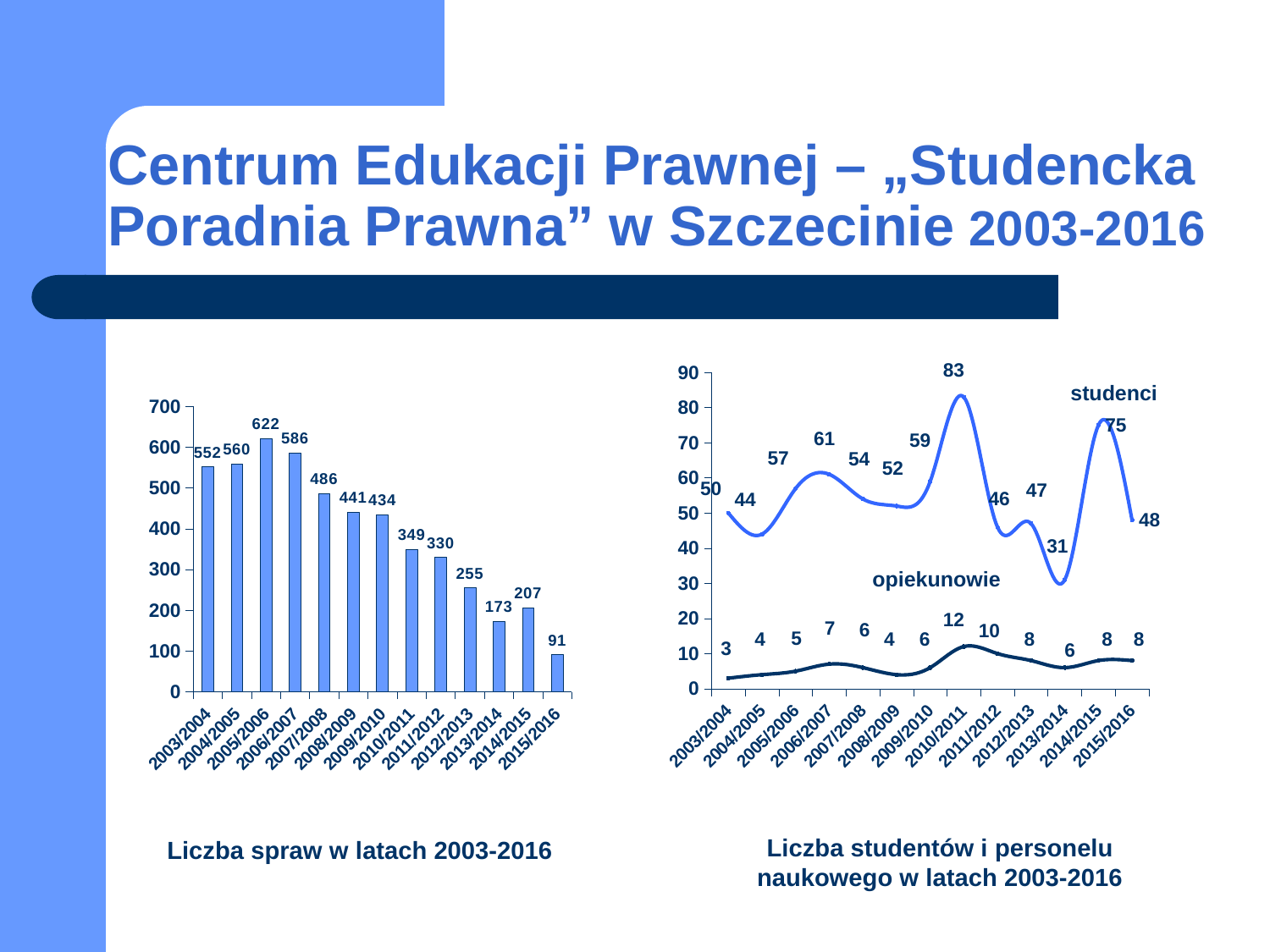
In the left chart (Liczba spraw w latach 2003-2016), do the values generally rise or fall from 2006/2007 to 2013/2014? Fall In the left chart (Liczba spraw w latach 2003-2016), which academic year has the lowest value? 2015/2016 In the left chart (Liczba spraw w latach 2003-2016), what is the value for 2005/2006? 622 In the left chart (Liczba spraw w latach 2003-2016), what is the difference between the values for 2003/2004 and 2015/2016? 461 In the left chart (Liczba spraw w latach 2003-2016), which academic year has the highest value? 2005/2006 In the right chart (Liczba studentów i personelu naukowego), which year has the lowest value for studenci? 2013/2014 What kind of chart is the left chart (Liczba spraw w latach 2003-2016)? Bar chart In the right chart (Liczba studentów i personelu naukowego), what is the value for opiekunowie in 2011/2012? 10 In the left chart (Liczba spraw w latach 2003-2016), how many academic years are shown on the x axis? 13 In the right chart (Liczba studentów i personelu naukowego), how many series are plotted? 2 In the right chart (Liczba studentów i personelu naukowego), what is the value for studenci in 2010/2011? 83 In the right chart (Liczba studentów i personelu naukowego), which is larger: studenci in 2014/2015 or studenci in 2015/2016? 2014/2015